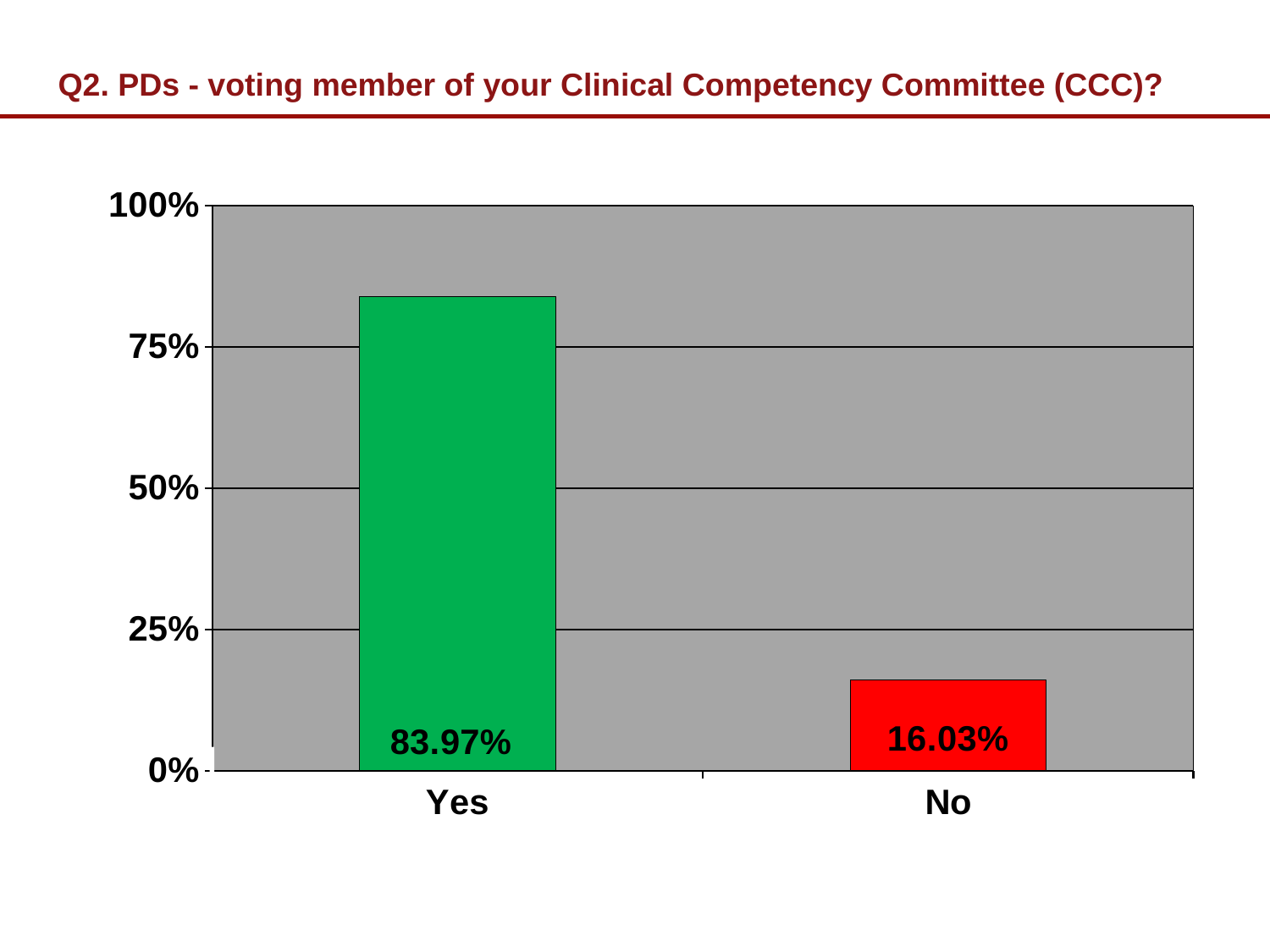
Which category has the lowest value? No Is the value for No greater or less than 25%? less Which category has the highest value? Yes Is the value for Yes greater or less than 75%? greater How many categories are shown on the x axis? 2 What kind of chart is shown on the slide? bar chart What is the title of the slide? Q2. PDs - voting member of your Clinical Competency Committee (CCC)? What is the value for Yes? 83.97% What is the difference between the values for Yes and No? 67.94% What colour is the bar for Yes? green What is the value for No? 16.03% Which is larger, the value for Yes or the value for No? Yes